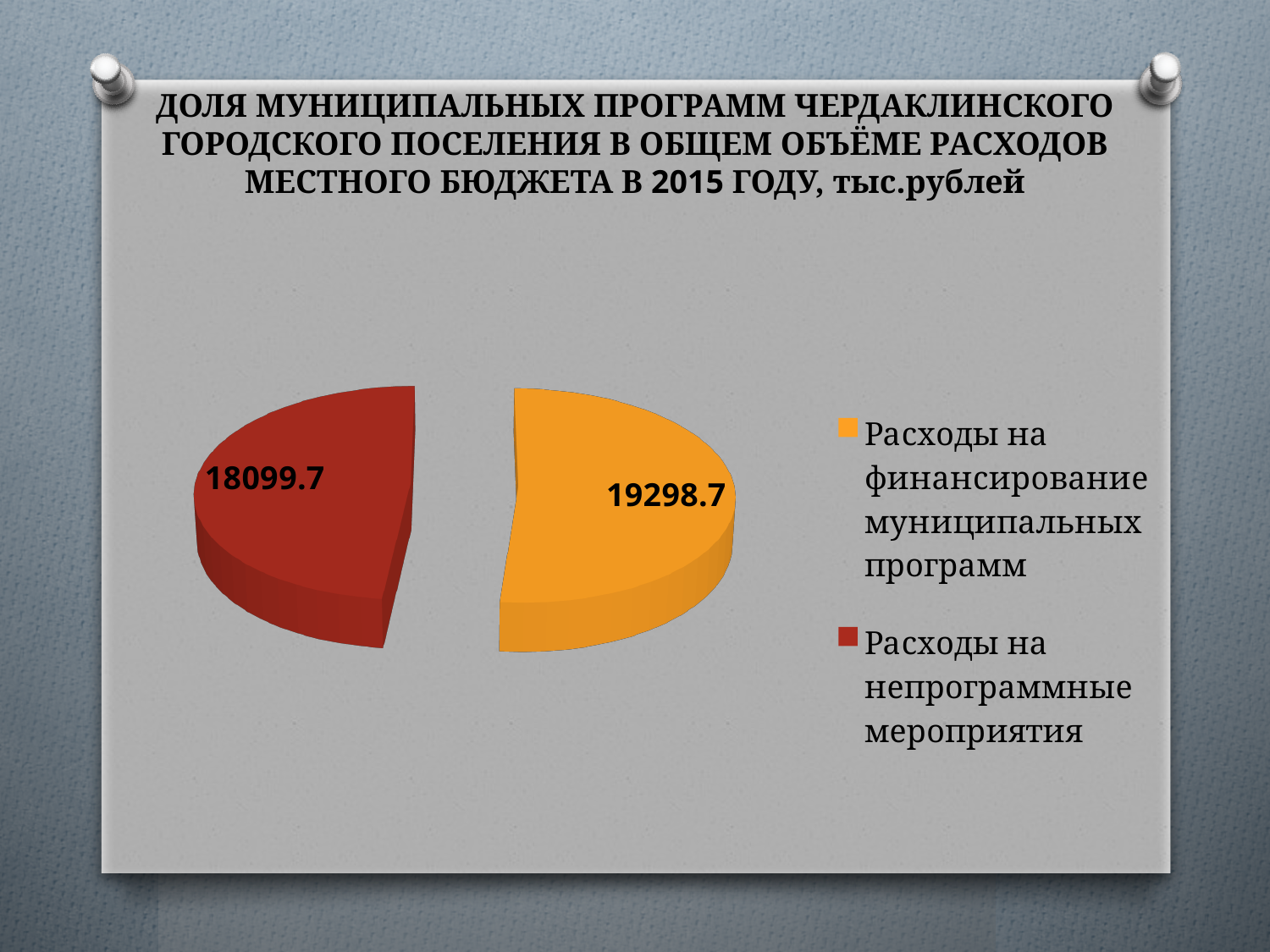
What is the difference between the value for "Расходы на финансирование муниципальных программ" and the value for "Расходы на непрограммные мероприятия"? 1199 Which category has the smallest slice of the pie? Расходы на непрограммные мероприятия How many slices does the pie chart have? 2 What kind of chart is shown on the slide? Pie chart In what unit are the values in the chart expressed, according to the title? тыс.рублей Which is larger: the value for "Расходы на финансирование муниципальных программ" or the value for "Расходы на непрограммные мероприятия"? Расходы на финансирование муниципальных программ What colour is the slice for "Расходы на непрограммные мероприятия"? Red What is the total of the two values shown in the pie chart? 37398.4 What is the value for "Расходы на финансирование муниципальных программ"? 19298.7 Which category has the largest slice of the pie? Расходы на финансирование муниципальных программ What is the value for "Расходы на непрограммные мероприятия"? 18099.7 What share of the pie does "Расходы на финансирование муниципальных программ" represent, to the nearest percent? 52%